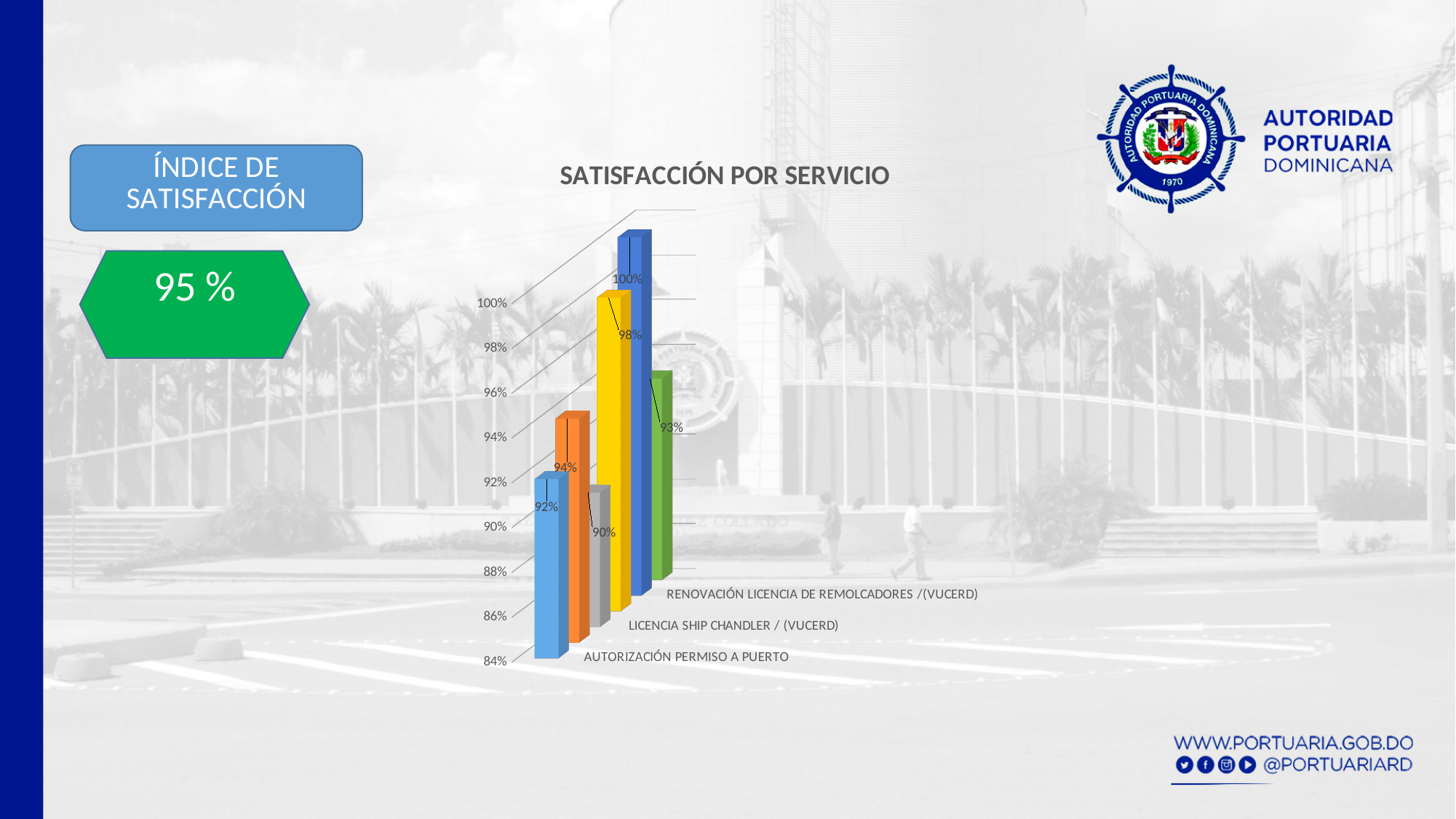
What is the title of the chart? SATISFACCIÓN POR SERVICIO What value is labelled on the yellow bar? 98% What value is labelled on the orange bar? 94% Which bar has the larger value, the orange bar or the green bar? orange bar What kind of chart is shown on the slide? bar chart What is the difference between the highest and lowest values in the chart? 10% How many bars are plotted in the chart? 6 What value is labelled on the green bar? 93% What is the lowest value shown in the chart? 90% What is the highest value shown in the chart? 100% What value is labelled on the gray bar? 90% What colour is the bar with the highest value? dark blue